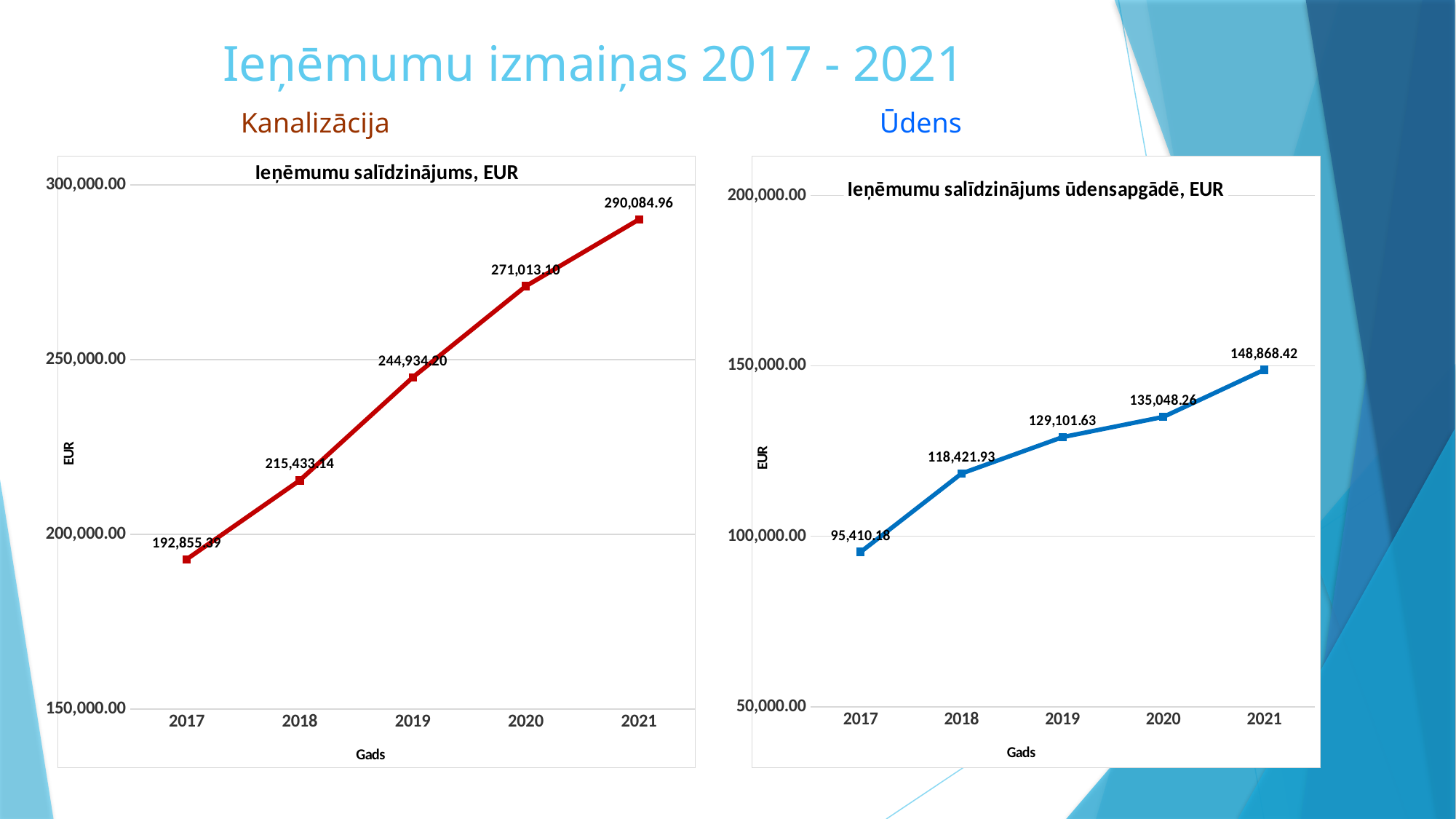
In the Ūdens chart, do the values rise or fall from 2017 to 2021? rise In the Ūdens chart, which year has the lowest value? 2017 How many years are plotted in the Ūdens chart? 5 In the Kanalizācija chart, what is the difference between the values for 2021 and 2020? 19,071.86 In the Ūdens chart, which is larger, the value for 2019 or the value for 2020? 2020 What is the title of the chart on the right side of the slide? Ieņēmumu salīdzinājums ūdensapgādē, EUR What kind of chart is the Kanalizācija chart? line chart In the Ūdens chart, what is the difference between the values for 2021 and 2017? 53,458.24 In the Kanalizācija chart, is the value for 2018 greater or less than 200,000.00? greater In the Ūdens chart, what is the value for 2018? 118,421.93 In the Kanalizācija chart, what is the value for 2019? 244,934.20 In the Kanalizācija chart, which year has the highest value? 2021